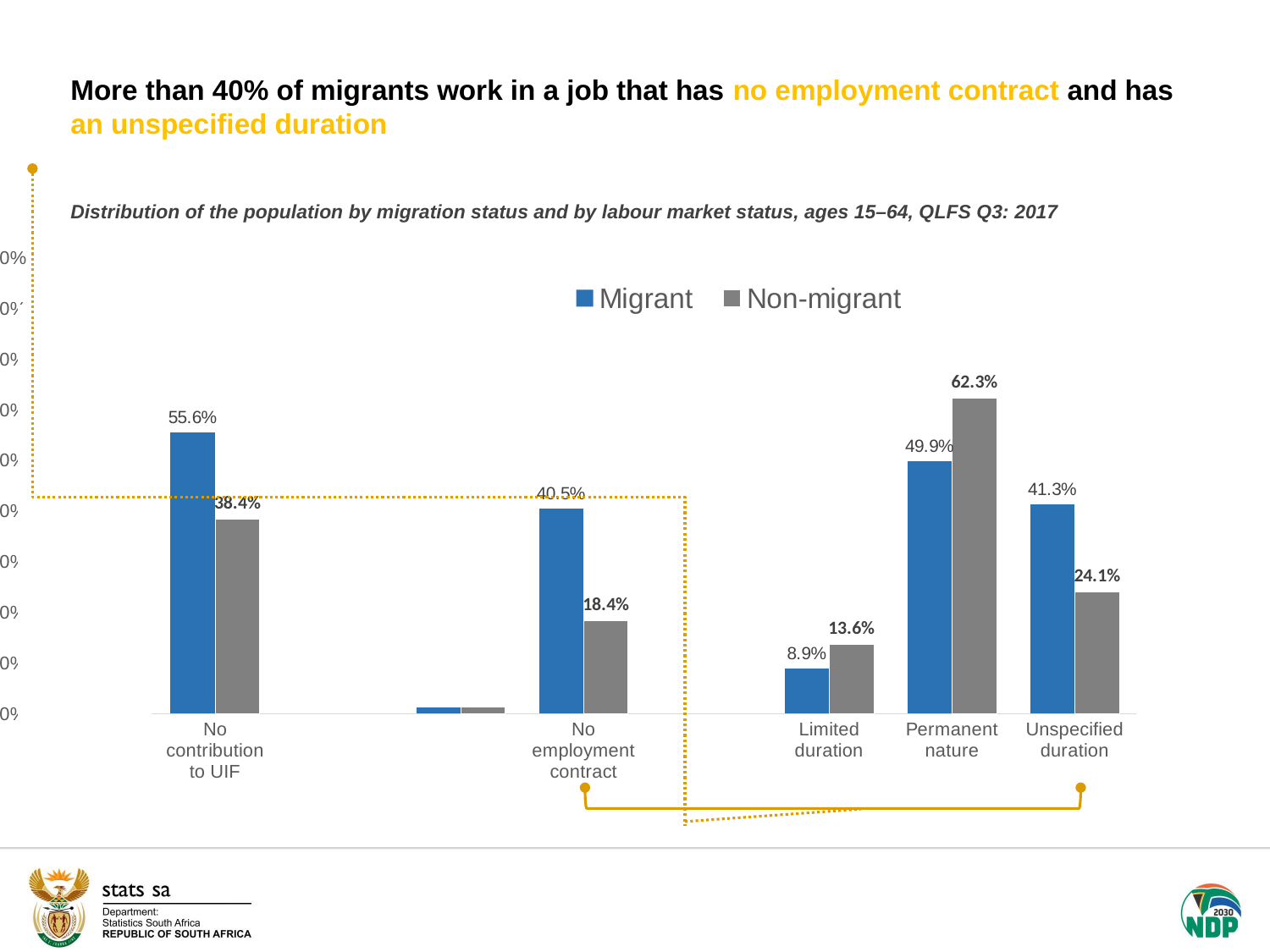
What is the Migrant value for Unspecified duration? 41.3% How many series does the legend list? 2 What is the difference between the Migrant and Non-migrant values for No employment contract? 22.1 percentage points For Unspecified duration, which is larger: the Migrant value or the Non-migrant value? Migrant What is the Non-migrant value for No employment contract? 18.4% For Permanent nature, which is larger: the Migrant value or the Non-migrant value? Non-migrant What is the Non-migrant value for Permanent nature? 62.3% What is the Migrant value for Limited duration? 8.9% What type of chart is shown on the slide? Bar chart Which category has the highest Non-migrant value? Permanent nature What is the Migrant value for No contribution to UIF? 55.6% Which labelled category has the lowest Migrant value? Limited duration